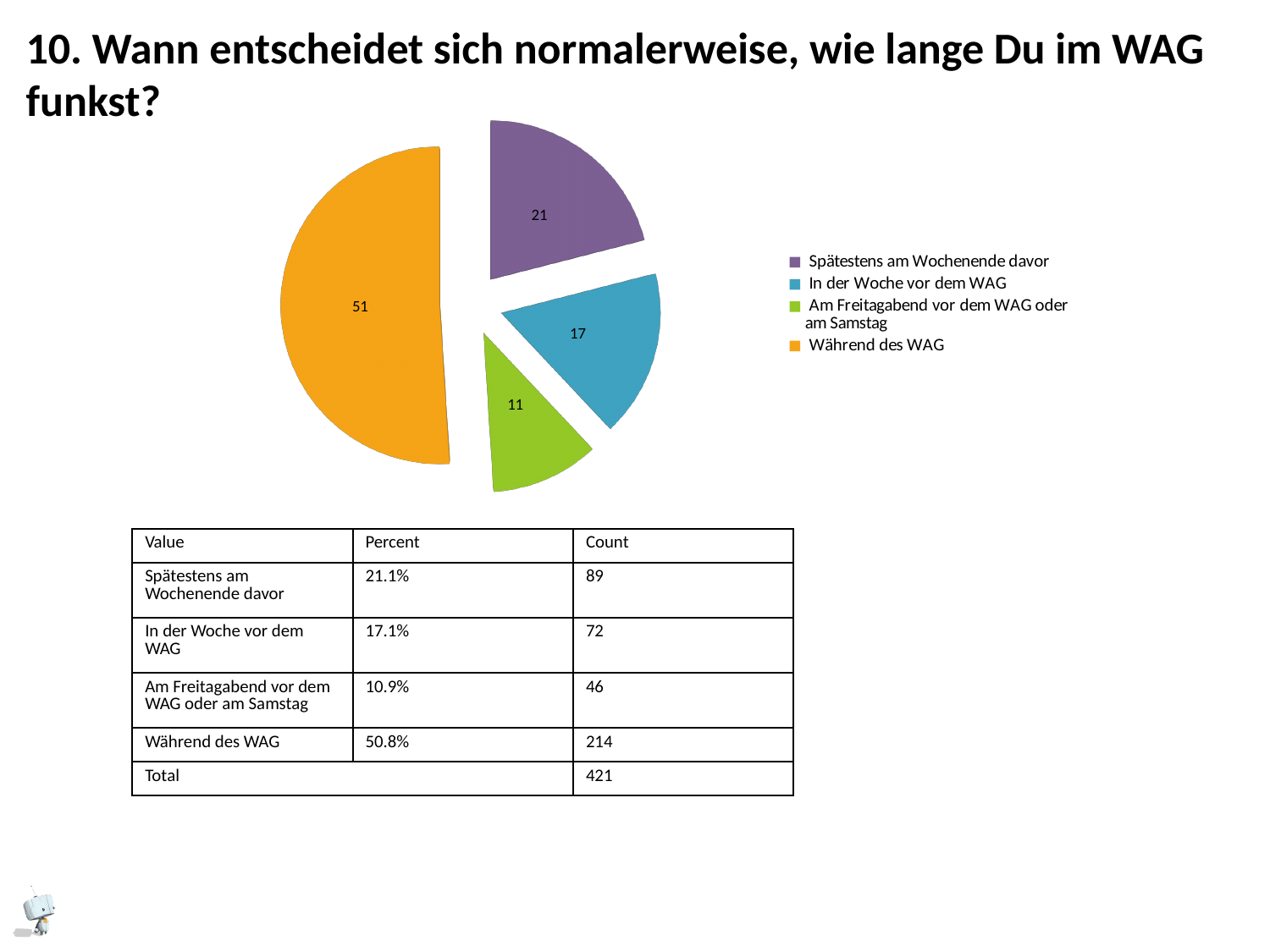
Which slice is larger: "In der Woche vor dem WAG" or "Am Freitagabend vor dem WAG oder am Samstag"? In der Woche vor dem WAG Which category has the largest slice of the pie? Während des WAG How many entries does the legend list? 4 What is the data label on the pie slice for "In der Woche vor dem WAG"? 17 How many slices does the pie chart have? 4 Which category has the smallest slice of the pie? Am Freitagabend vor dem WAG oder am Samstag What is the difference between the data labels for "Während des WAG" and "Spätestens am Wochenende davor"? 30 What type of chart is shown on the slide? pie chart What colour is the slice for "Während des WAG"? orange What is the data label on the pie slice for "Am Freitagabend vor dem WAG oder am Samstag"? 11 What is the data label on the pie slice for "Während des WAG"? 51 What is the data label on the pie slice for "Spätestens am Wochenende davor"? 21